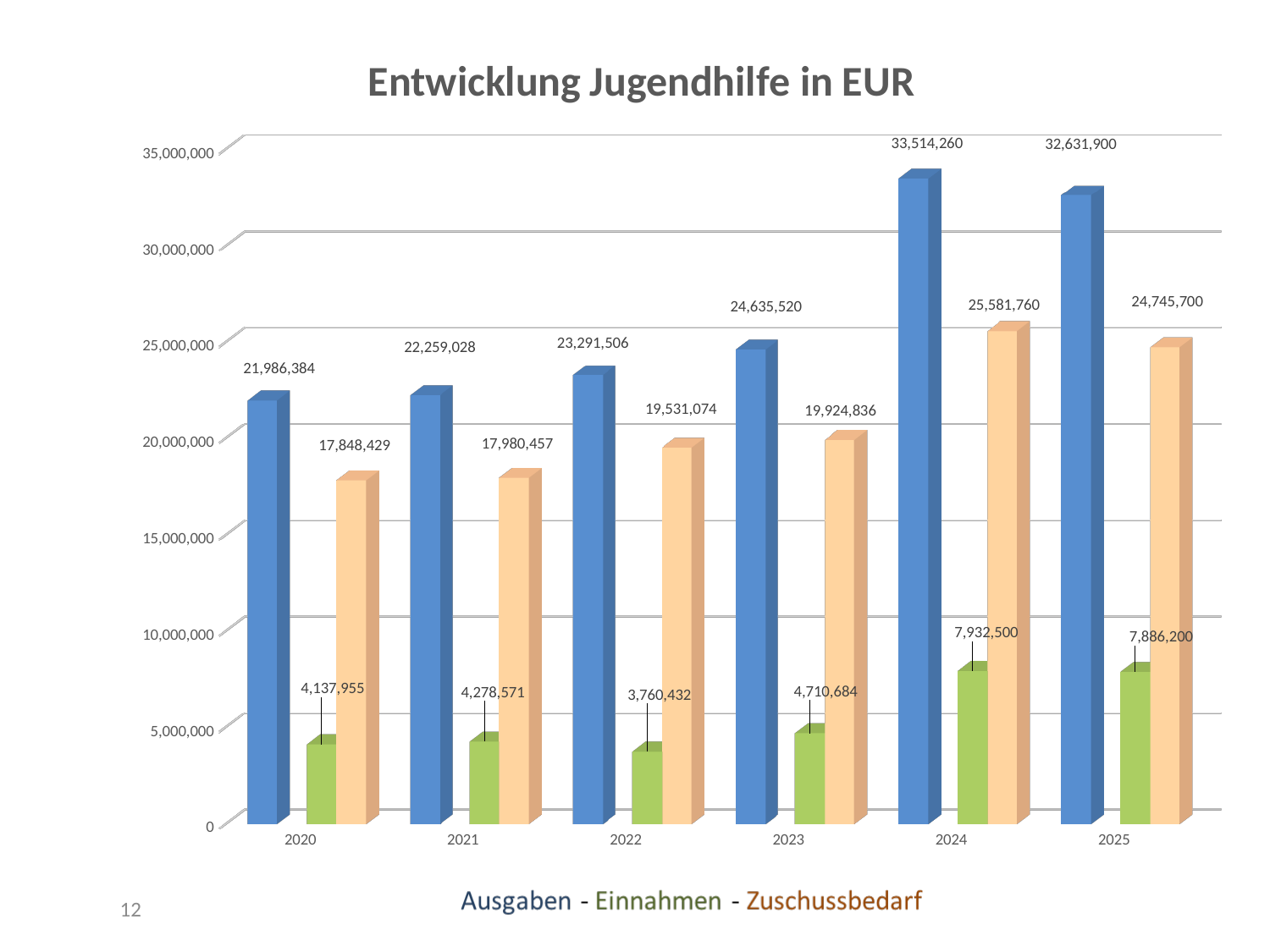
What is the title of the chart? Entwicklung Jugendhilfe in EUR What is the difference between Ausgaben and Zuschussbedarf in 2020? 4,137,955 What is the Zuschussbedarf value for 2025? 24,745,700 What is the Einnahmen value for 2022? 3,760,432 What is the Ausgaben value for 2024? 33,514,260 By how much did Ausgaben increase from 2023 to 2024? 8,878,740 Which is larger, Zuschussbedarf in 2024 or Zuschussbedarf in 2025? Zuschussbedarf in 2024 How many years are shown on the x axis? 6 In which year is Ausgaben highest? 2024 What kind of chart is shown on the slide? Bar chart How many series does the legend list? 3 In which year is Einnahmen lowest? 2022